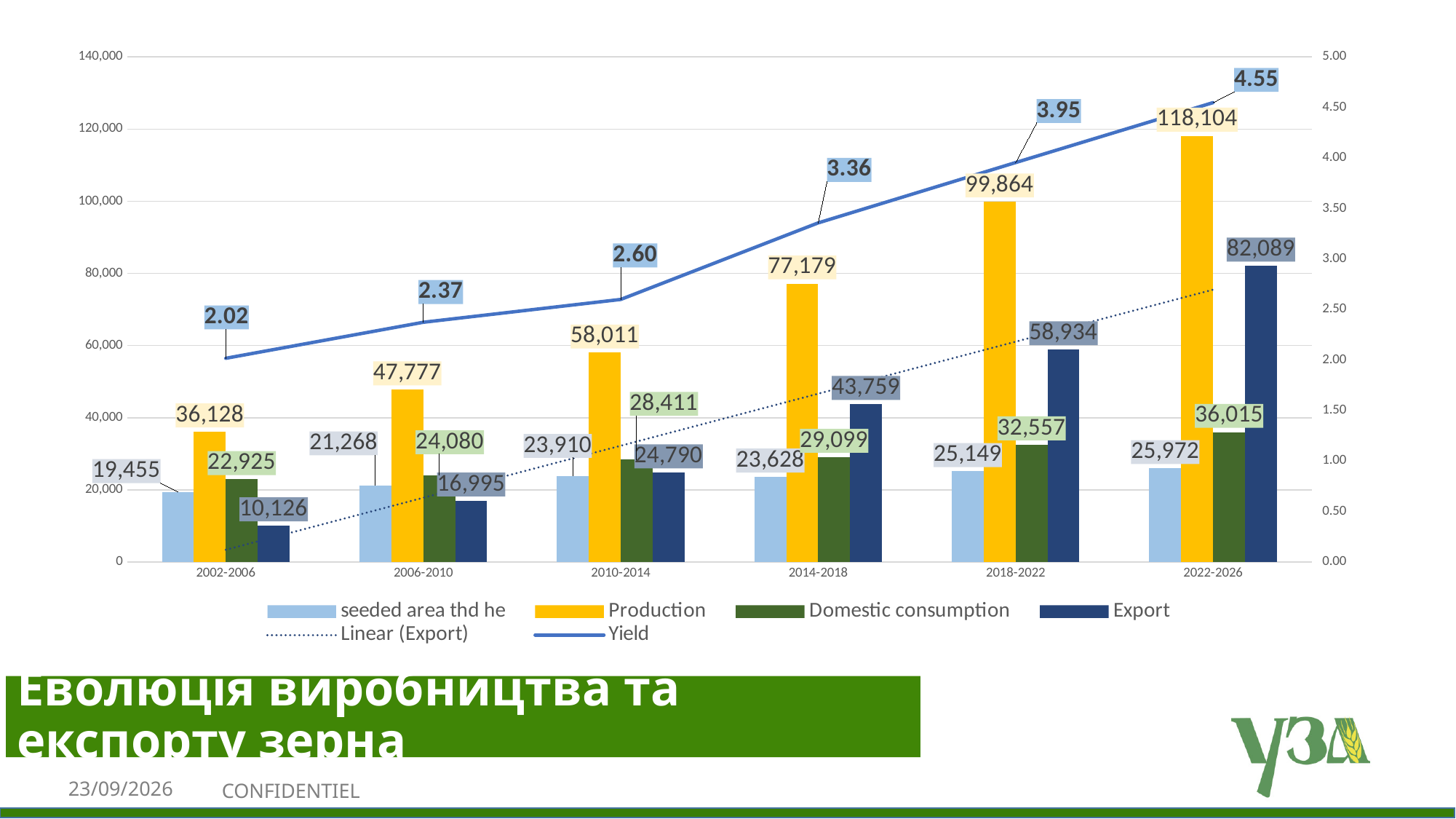
What is the Domestic consumption value for 2006-2010? 24,080 Does the Yield line rise or fall from 2002-2006 to 2022-2026? rise Which period has the highest Production value? 2022-2026 In 2010-2014, which is larger: Domestic consumption or Export? Domestic consumption What is the Yield value for 2010-2014? 2.60 What is the Export value for 2014-2018? 43,759 How many series does the legend list? 6 What colour are the Production bars? yellow How many periods are shown on the x axis? 6 Which period has the lowest Export value? 2002-2006 What is the Production value for 2022-2026? 118,104 What is the difference between the Export values for 2018-2022 and 2014-2018? 15,175